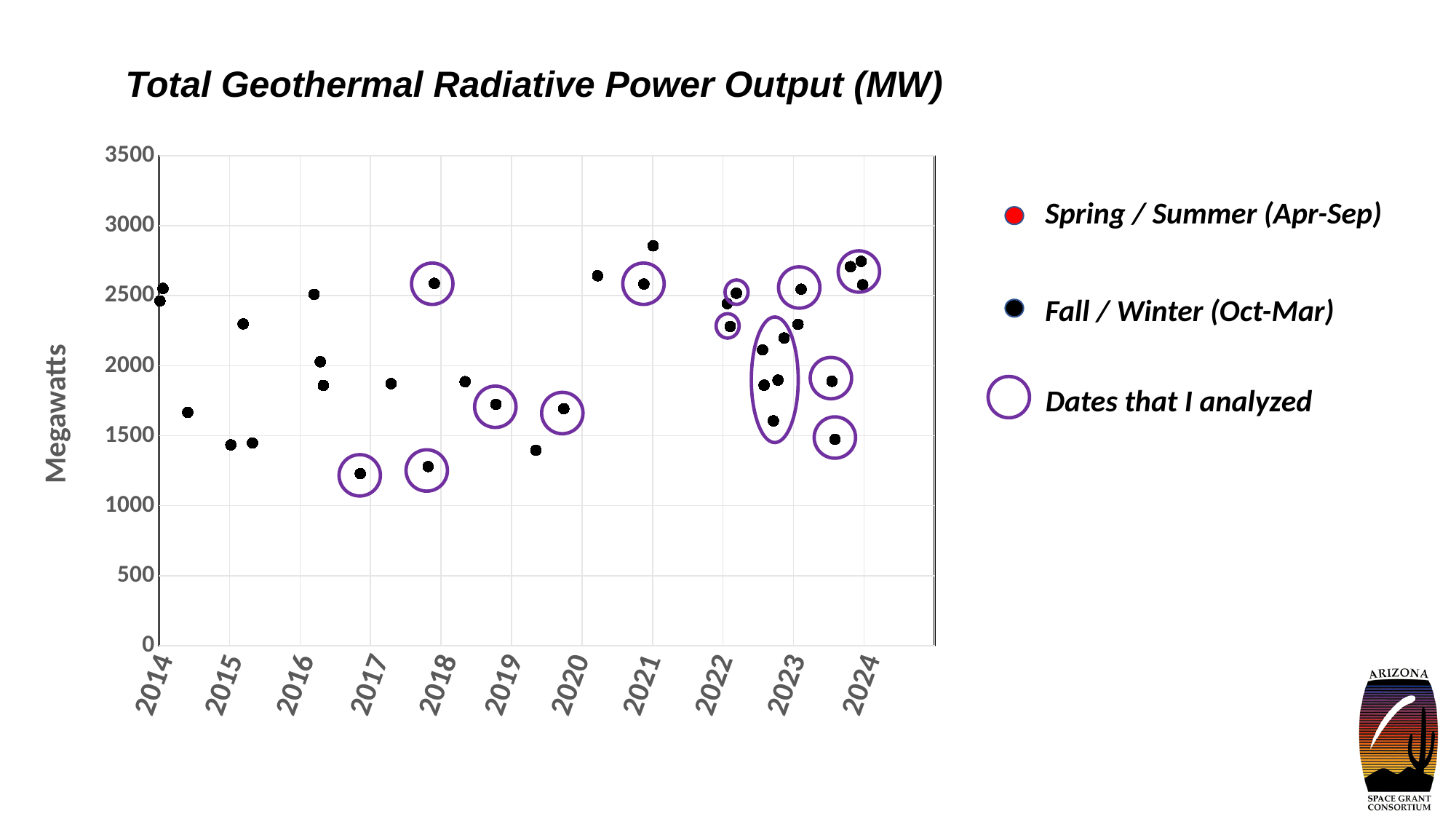
What is the highest value shown on the vertical axis? 3500 Is the highest point on the chart greater or less than 3000? less What is the label on the vertical axis of the chart? Megawatts Is the highest point on the chart greater or less than 2500? greater What kind of chart is shown on the slide? Scatter chart What is the title of the chart? Total Geothermal Radiative Power Output (MW) Is the lowest point on the chart greater or less than 1000? greater What is the first year labelled on the horizontal axis? 2014 How many year labels are shown on the horizontal axis? 11 How many entries does the chart's legend list? 3 What is the last year labelled on the horizontal axis? 2024